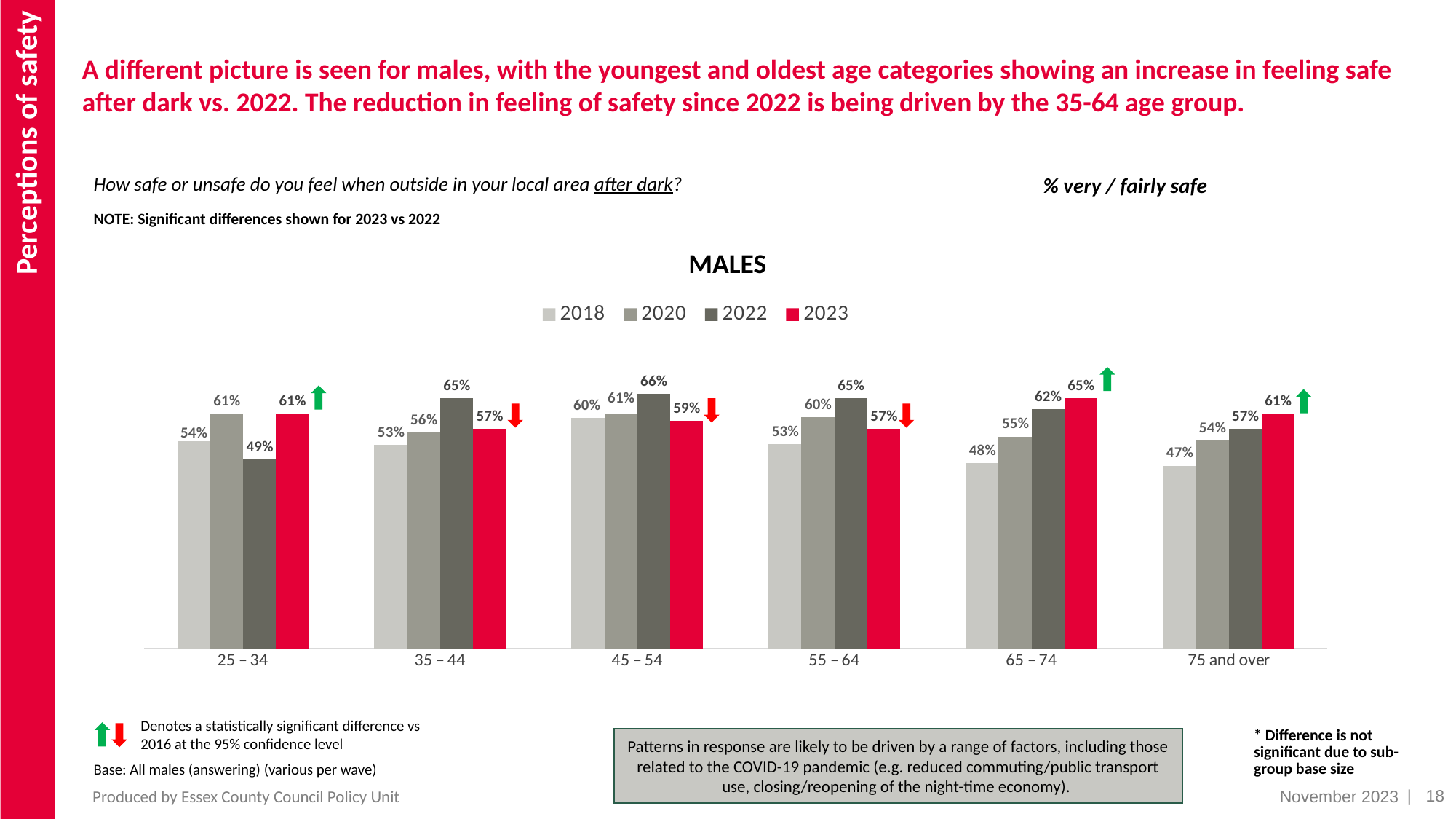
How many age groups are shown on the x axis? 6 How many series does the legend list? 4 What is the 2018 value for the 75 and over age group? 47% Do the 2018 values rise or fall from the 45 – 54 age group to the 75 and over age group? Fall Which age group has the highest 2023 value? 65 – 74 What is the 2023 value for the 25 – 34 age group? 61% What is the difference between the 2022 and 2023 values for the 35 – 44 age group? 8% What kind of chart is shown on the slide? Bar chart What is the title of the chart? MALES What is the 2022 value for the 45 – 54 age group? 66% Which age group has the lowest 2022 value? 25 – 34 Which is larger for the 55 – 64 age group, the 2020 value or the 2023 value? 2020